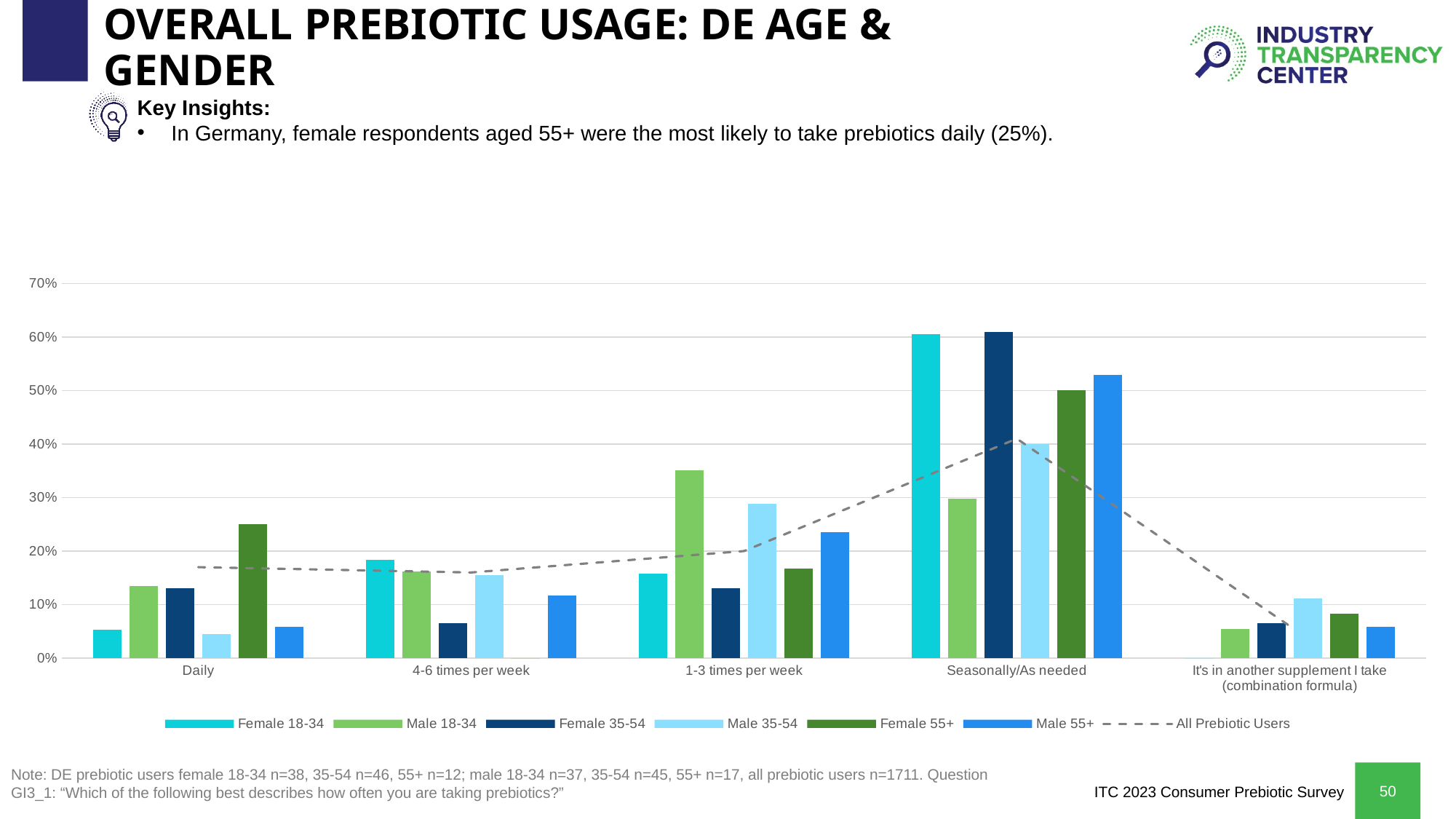
Which series is drawn as a dashed line rather than bars? All Prebiotic Users Does the All Prebiotic Users line rise or fall from Daily to Seasonally/As needed? rises Which group has the highest value in the Daily category? Female 55+ What kind of chart is shown on the slide? combination bar and line chart In the Seasonally/As needed category, which is larger: Female 35-54 or Male 55+? Female 35-54 How many series does the legend list? 7 What percentage of female respondents aged 55+ take prebiotics daily, according to the slide? 25% Is the value for Male 18-34 in the 1-3 times per week category greater or less than 30%? greater How many frequency categories are shown on the x axis? 5 Which group has the lowest value in the 1-3 times per week category? Female 35-54 Is the value for Female 55+ in the Seasonally/As needed category greater or less than 40%? greater Is the value for Male 35-54 in the Daily category greater or less than 10%? less